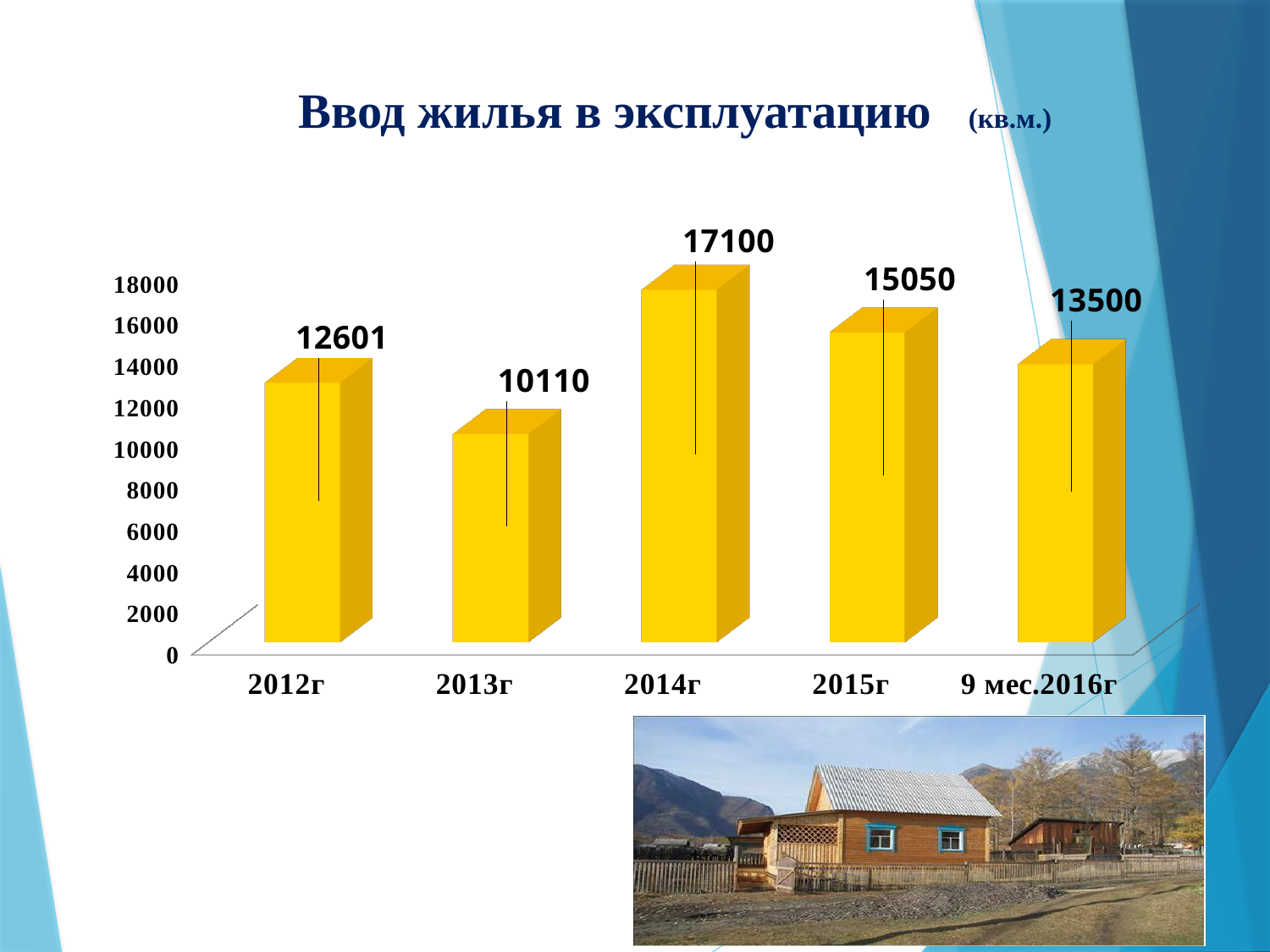
How many categories are shown on the x axis? 5 Which category has the lowest value? 2013г Which category has the highest value? 2014г What is the title of the chart? Ввод жилья в эксплуатацию (кв.м.) Is the value for 2012г greater or less than 12000? greater What is the value for 2014г? 17100 What is the value for 2013г? 10110 What is the difference between the values for 2012г and 2013г? 2491 What kind of chart is shown on the slide? bar chart What is the value for 9 мес.2016г? 13500 Which is larger, the value for 2015г or the value for 9 мес.2016г? 2015г What is the difference between the values for 2014г and 2015г? 2050